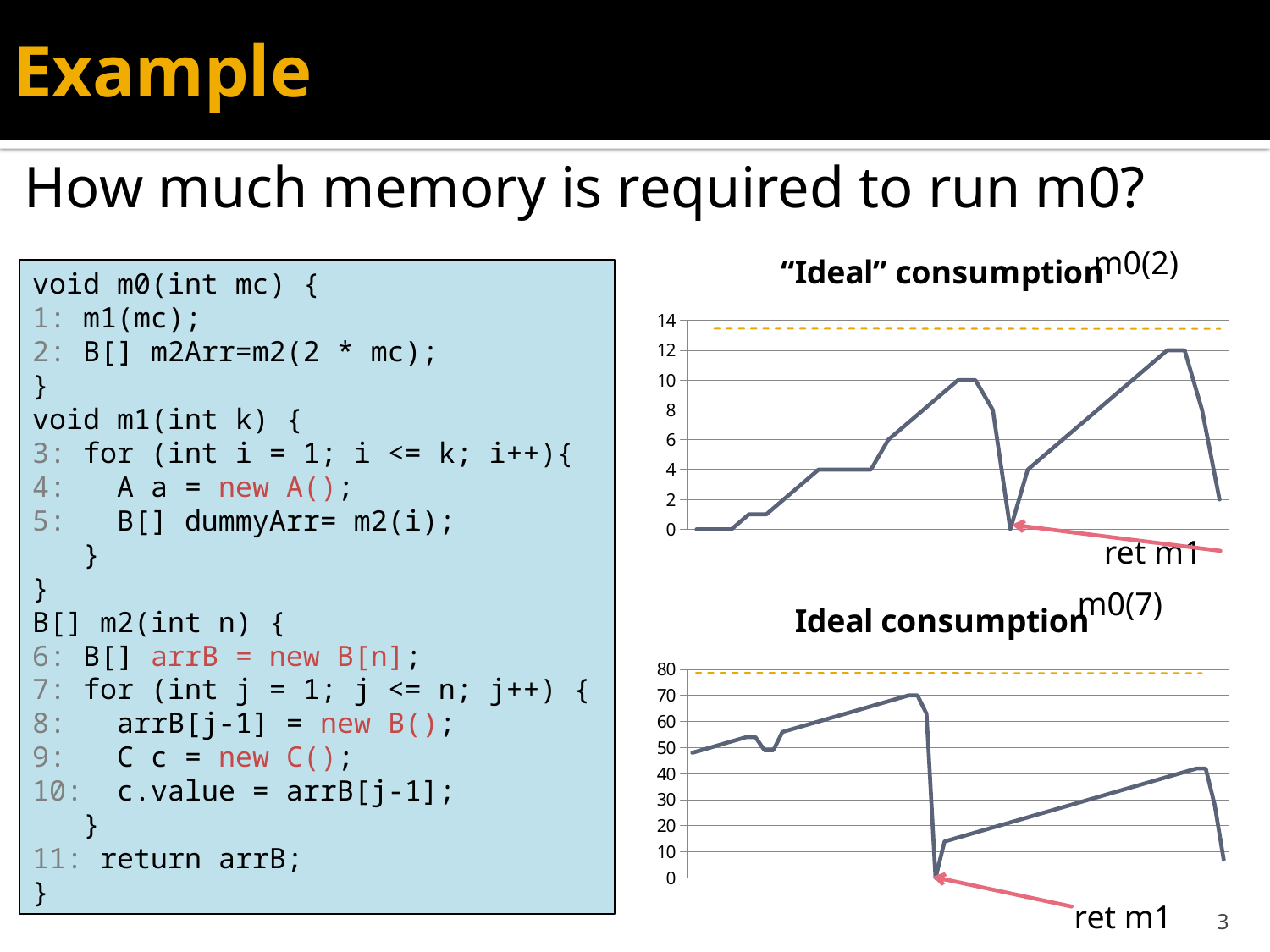
In the bottom chart (Ideal consumption, m0(7)), what is the lowest value the line reaches? 0 What kind of chart is the Ideal consumption chart for m0(7) at the bottom right? line chart In the bottom chart (Ideal consumption, m0(7)), is the starting value of the line greater or less than 40? greater In the top chart ("Ideal" consumption, m0(2)), what is the lowest value the line reaches? 0 In the bottom chart (Ideal consumption, m0(7)), what is the highest value shown on the vertical axis? 80 In the top chart ("Ideal" consumption, m0(2)), is the final value of the line greater or less than 4? less In the top chart ("Ideal" consumption, m0(2)), what is the highest value the line reaches? 12 In the bottom chart (Ideal consumption, m0(7)), what is the highest value the line reaches? 70 In the bottom chart (Ideal consumption, m0(7)), is the final value of the line greater or less than 20? less In the bottom chart (Ideal consumption, m0(7)), does the line rise or fall between its starting point and its first peak? rise In the top chart ("Ideal" consumption, m0(2)), what is the highest value shown on the vertical axis? 14 What kind of chart is the "Ideal" consumption chart for m0(2) at the top right? line chart